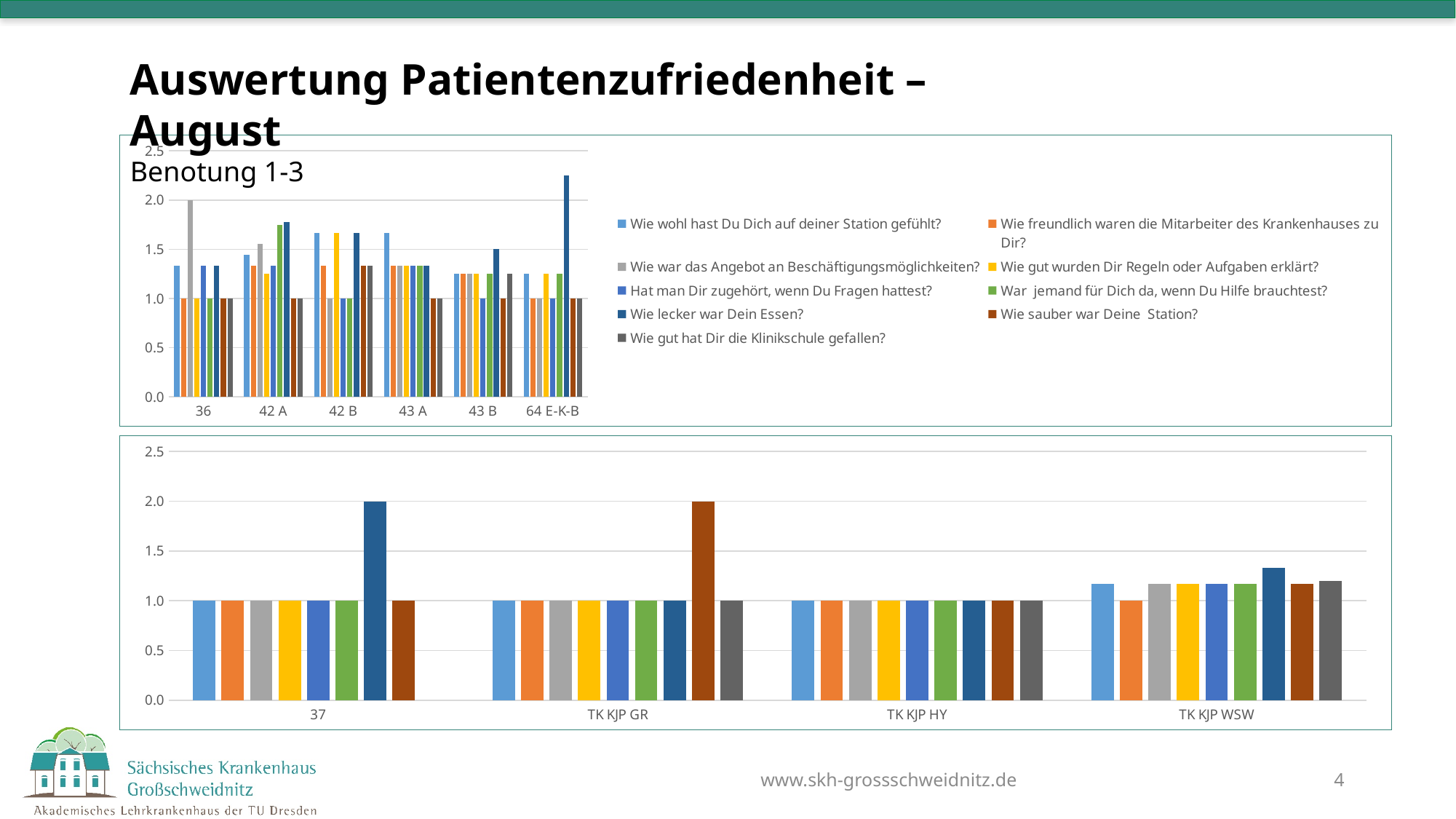
In the bottom chart, what is the value of the brown bar ('Wie sauber war Deine Station?') for TK KJP GR? 2.0 What kind of chart is the top chart on the slide? bar chart How many series does the legend of the top chart list? 9 How many categories are shown on the x axis of the bottom chart? 4 In the bottom chart, is the value of the dark blue bar ('Wie lecker war Dein Essen?') for TK KJP WSW greater or less than 1.0? greater How many categories are shown on the x axis of the top chart? 6 In the bottom chart, which is larger: the dark blue bar ('Wie lecker war Dein Essen?') for 37 or for TK KJP HY? 37 In the top chart, what is the value for 'Wie freundlich waren die Mitarbeiter des Krankenhauses zu Dir?' for category 36? 1.0 In the bottom chart, what is the value of the dark blue bar ('Wie lecker war Dein Essen?') for category 37? 2.0 In the top chart, is the value for 'Wie lecker war Dein Essen?' for 64 E-K-B greater or less than 2.0? greater In the top chart, what is the value for 'Wie war das Angebot an Beschäftigungsmöglichkeiten?' for category 36? 2.0 In the top chart, which series has the highest value for category 64 E-K-B? Wie lecker war Dein Essen?